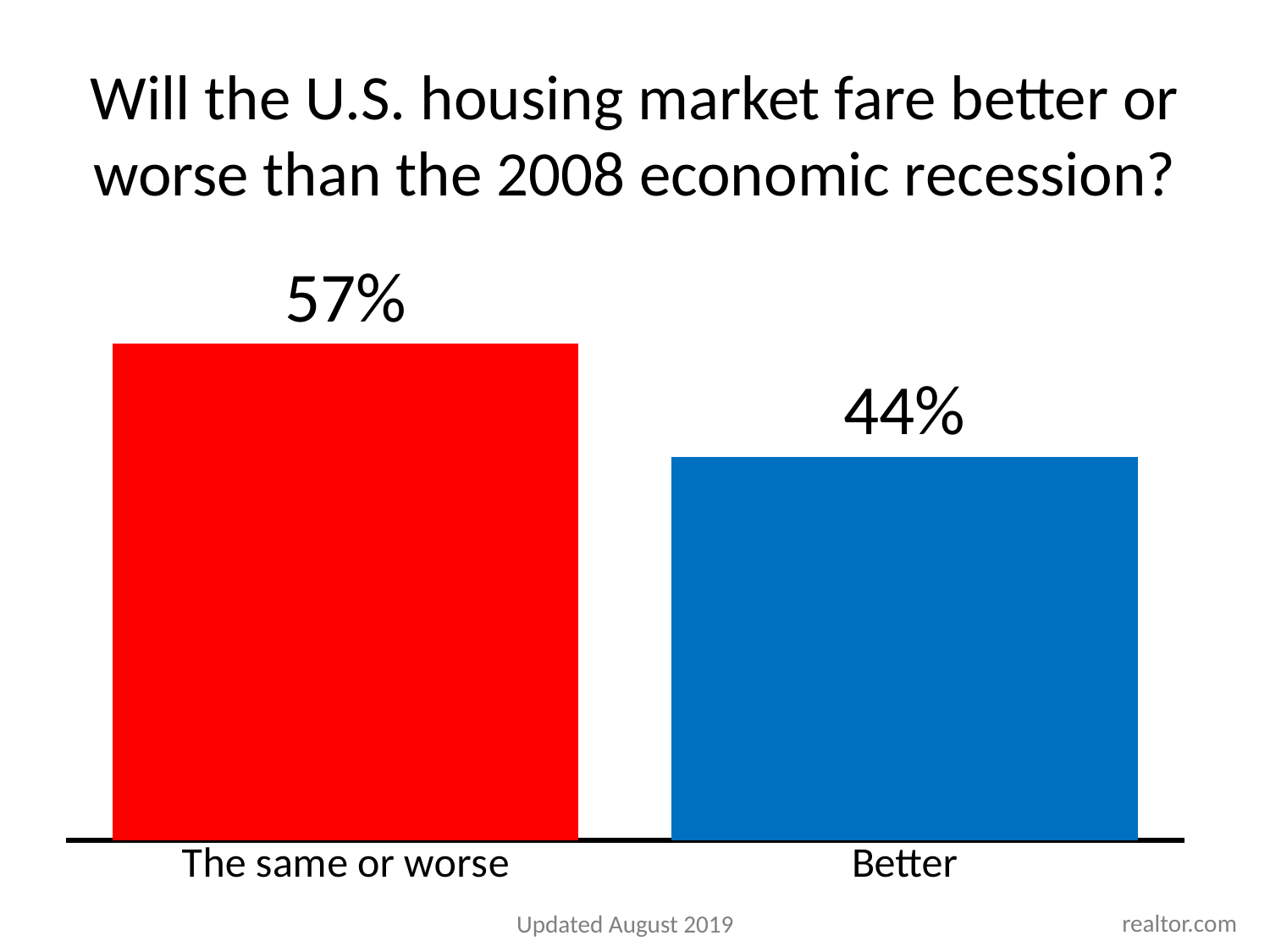
Which category has the lowest value on the chart? Better Which is larger: the value for 'The same or worse' or the value for 'Better'? The same or worse Is the value for 'Better' greater or less than 50%? less Is the value for 'The same or worse' greater or less than 50%? greater What is the difference in percentage points between 'The same or worse' and 'Better'? 13 percentage points What percentage of respondents said the U.S. housing market will fare the same or worse than the 2008 economic recession? 57% What is the title of the chart? Will the U.S. housing market fare better or worse than the 2008 economic recession? What kind of chart is shown on the slide? Bar chart What colour is the bar for 'Better'? Blue What percentage of respondents said the U.S. housing market will fare better than the 2008 economic recession? 44% How many categories are shown on the chart? 2 Which category has the highest value on the chart? The same or worse